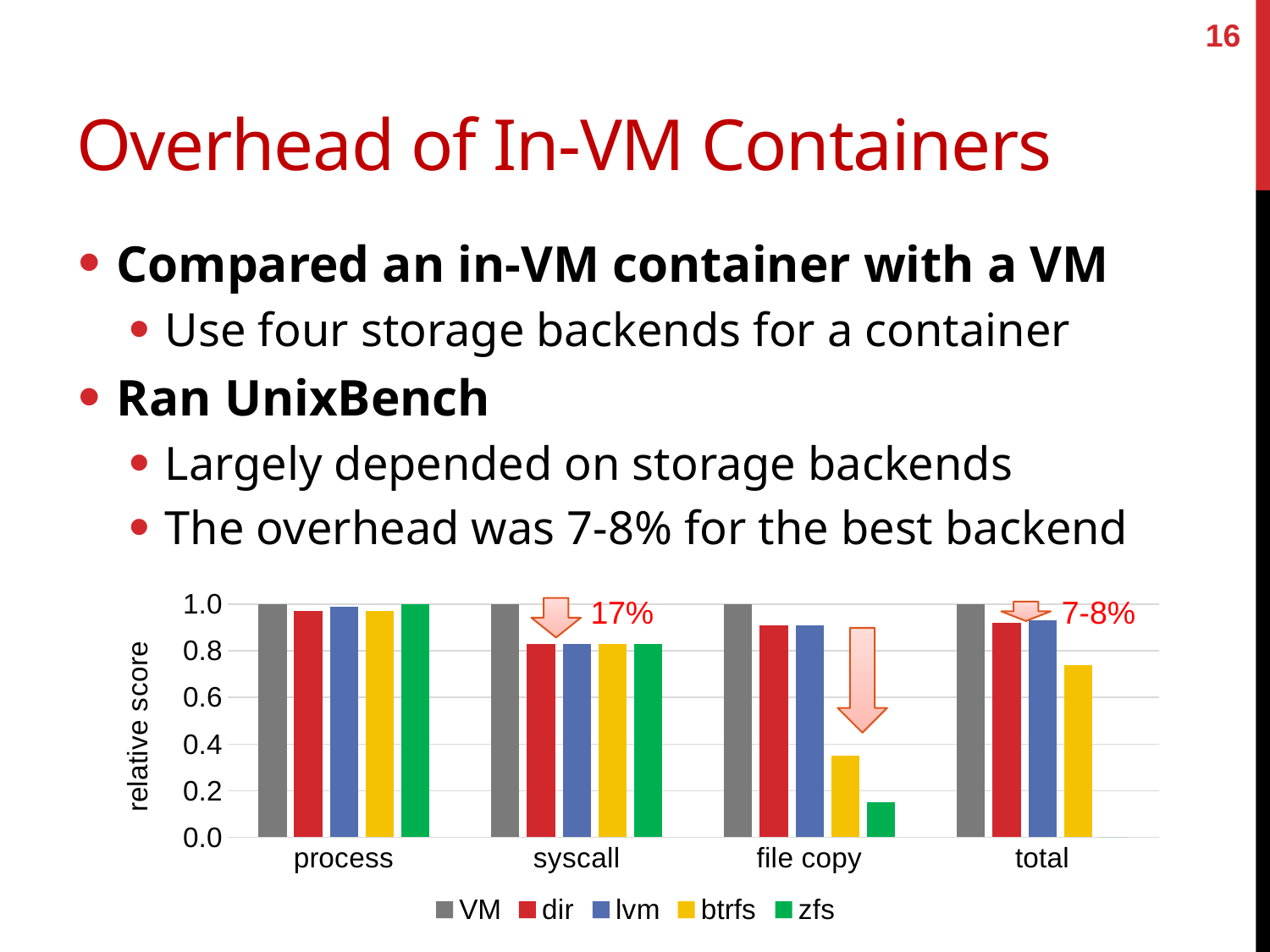
Is the value for btrfs in the file copy category greater or less than 0.4? less How many categories are shown on the x axis of the chart? 4 How many series does the chart's legend list? 5 What percentage is annotated next to the syscall bars? 17% In which category does btrfs have its lowest value? file copy What kind of chart is shown on the slide? bar chart In the file copy category, which is larger: dir or btrfs? dir What is the relative score of VM for the process category? 1.0 What is the label on the y axis of the chart? relative score Is the value for zfs in the file copy category greater or less than 0.2? less Is the value for btrfs in the total category greater or less than 0.8? less Which series has the lowest value in the file copy category? zfs